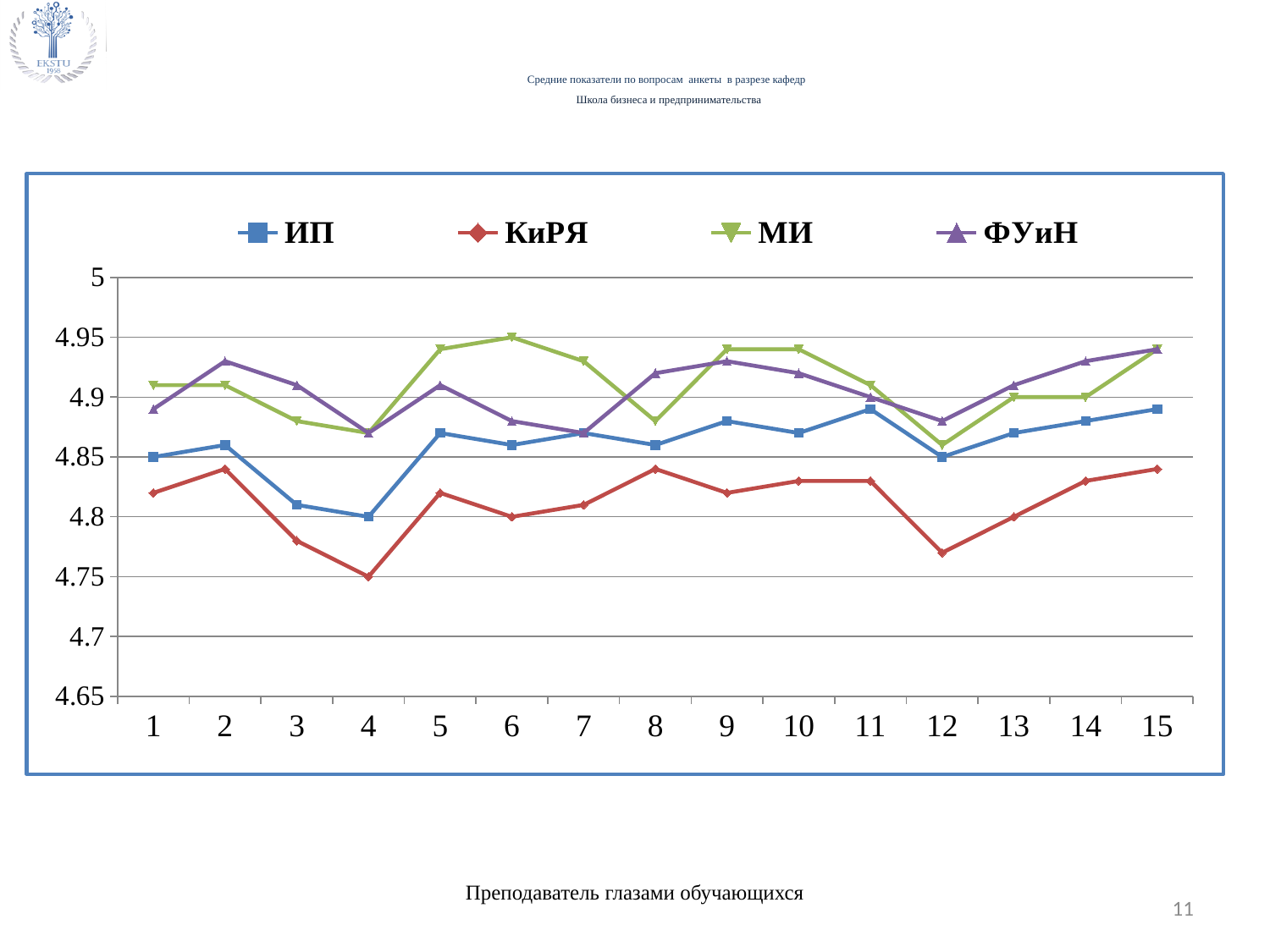
What kind of chart is shown on the slide? line chart Is the value for ФУиН at point 4 greater or less than 4.9? less At which point does the КиРЯ series reach its lowest value? 4 What are the four series named in the legend? ИП, КиРЯ, МИ, ФУиН Is the value for ИП at point 12 greater or less than 4.9? less Which series has the lowest values across all 15 points? КиРЯ Is the value for МИ at point 6 greater or less than 4.9? greater At point 4, which series has the higher value, ИП or КиРЯ? ИП How many points are plotted along the x axis for each series? 15 How many series does the legend list? 4 At point 2, which series has the higher value, ФУиН or МИ? ФУиН